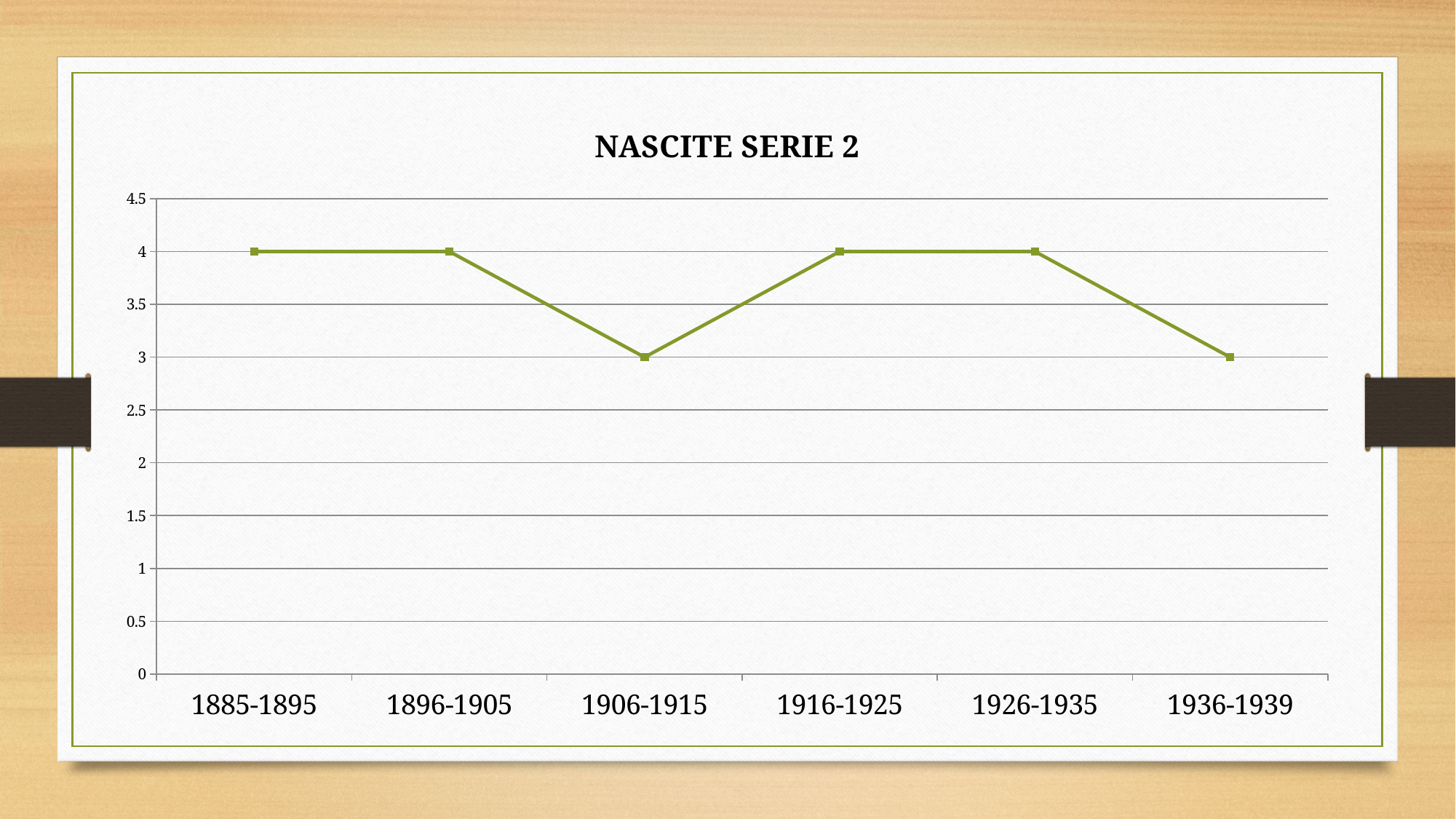
What is the value for 1916-1925? 4 What kind of chart is shown on the slide? line chart Which period has the lowest value, 1906-1915 or 1926-1935? 1906-1915 What is the value for 1936-1939? 3 Does the value rise or fall from 1926-1935 to 1936-1939? fall Is the value for 1926-1935 greater or less than 3.5? greater What is the title of the chart? NASCITE SERIE 2 How many periods are plotted along the x axis? 6 What is the difference between the values for 1896-1905 and 1906-1915? 1 What is the value for 1885-1895? 4 What is the value for 1906-1915? 3 Does the value rise or fall from 1906-1915 to 1916-1925? rise